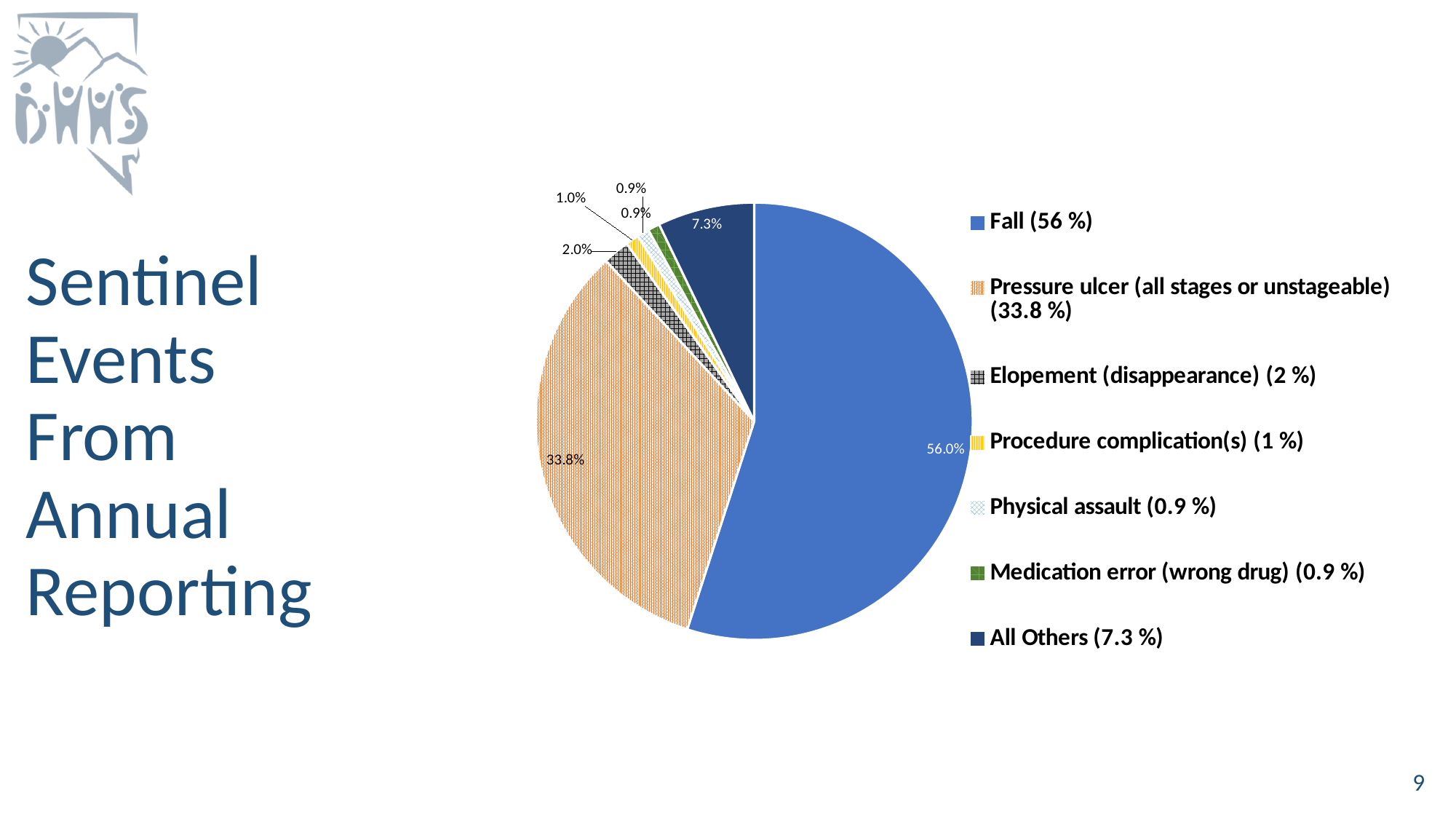
Which is larger, the Pressure ulcer slice or the All Others slice? Pressure ulcer (all stages or unstageable) What percentage does the legend give for Physical assault? 0.9 % Which legend entry is shown with a green marker? Medication error (wrong drug) (0.9 %) What share of the pie does the Fall slice represent? 56.0% Which category has the largest slice of the pie? Fall How many categories does the legend list? 7 What is the data label on the All Others slice? 7.3% What is the data label on the Elopement (disappearance) slice? 2.0% What is the difference in percentage points between the Fall slice and the Pressure ulcer slice? 22.2 What kind of chart is shown on the slide? pie chart What is the data label on the Pressure ulcer (all stages or unstageable) slice? 33.8% What is the difference in percentage points between the All Others slice and the Elopement (disappearance) slice? 5.3